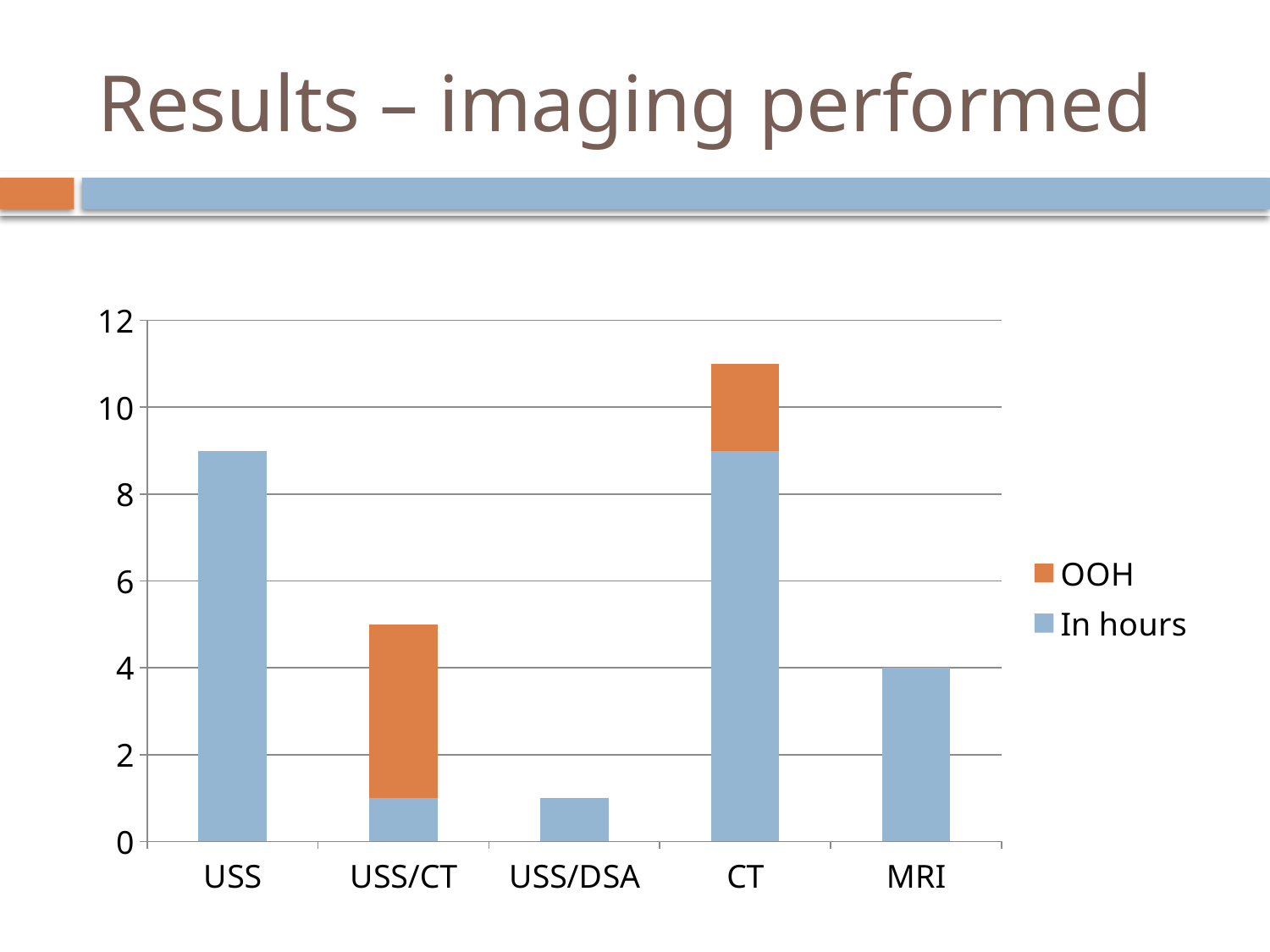
Is the In hours value for USS/DSA greater or less than 2? less How many categories are shown on the x axis of the chart? 5 What is the title of the slide containing the chart? Results – imaging performed Is the total value for CT greater or less than 10? greater What is the In hours value for MRI? 4 Which is larger, the total bar for USS/CT or the total bar for MRI? USS/CT Which categories have an OOH segment in their bar? USS/CT and CT How many series does the chart legend list? 2 Is the In hours value for USS greater or less than 8? greater Which category has the tallest bar overall? CT What kind of chart is shown on the slide? bar chart Which category has the shortest bar overall? USS/DSA